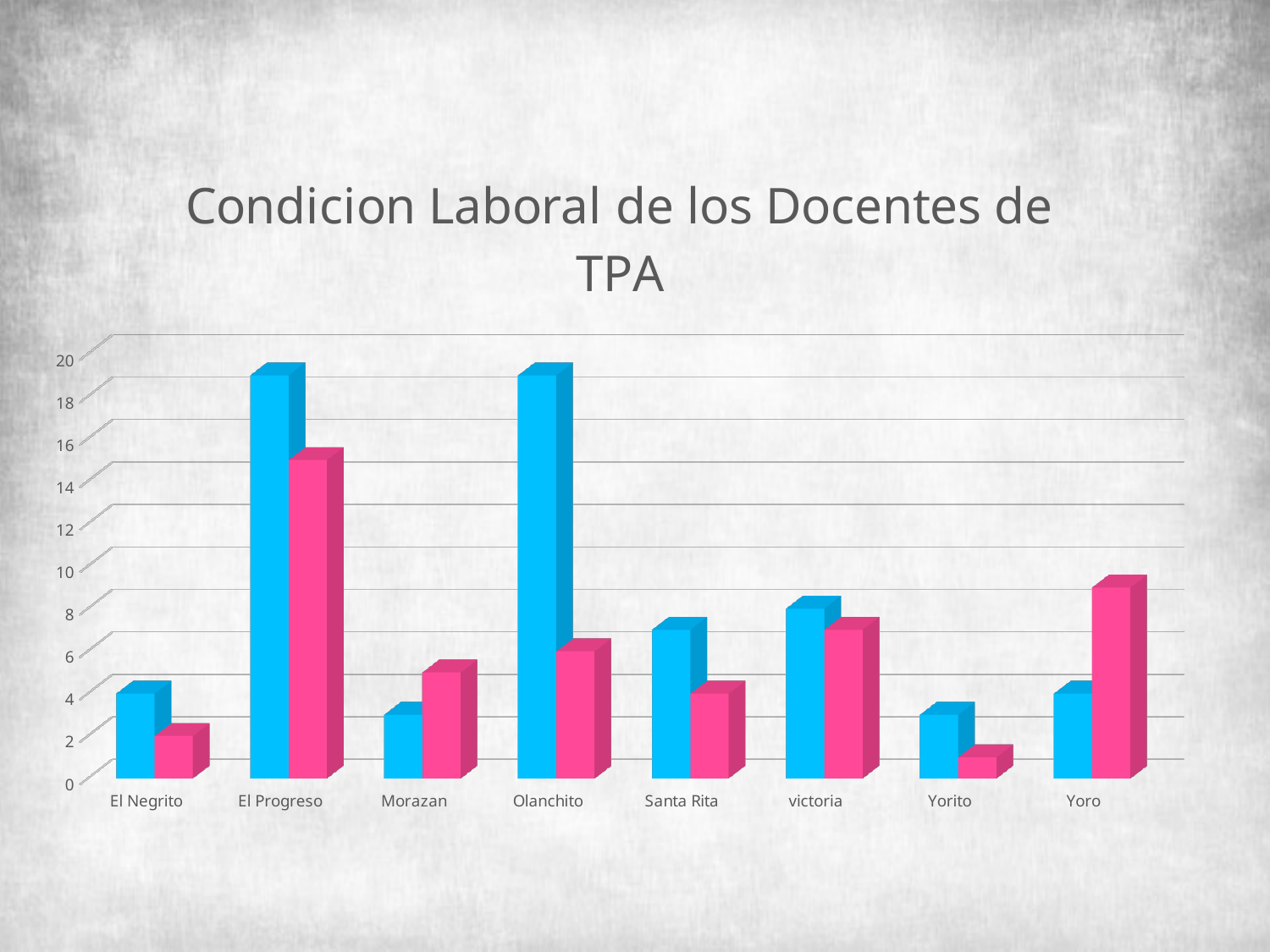
What is the title of the chart? Condicion Laboral de los Docentes de TPA Is the pink bar for Yoro greater or less than 6? greater For Yoro, which bar is taller, the blue one or the pink one? the pink one Is the pink bar for El Progreso greater or less than 10? greater Which category has the shortest pink bar? Yorito Is the pink bar for Yorito greater or less than 2? less What type of chart is shown on the slide? bar chart For Morazan, which bar is taller, the blue one or the pink one? the pink one How many categories are shown on the x axis of the chart? 8 For Olanchito, which bar is taller, the blue one or the pink one? the blue one Which category has the tallest pink bar? El Progreso